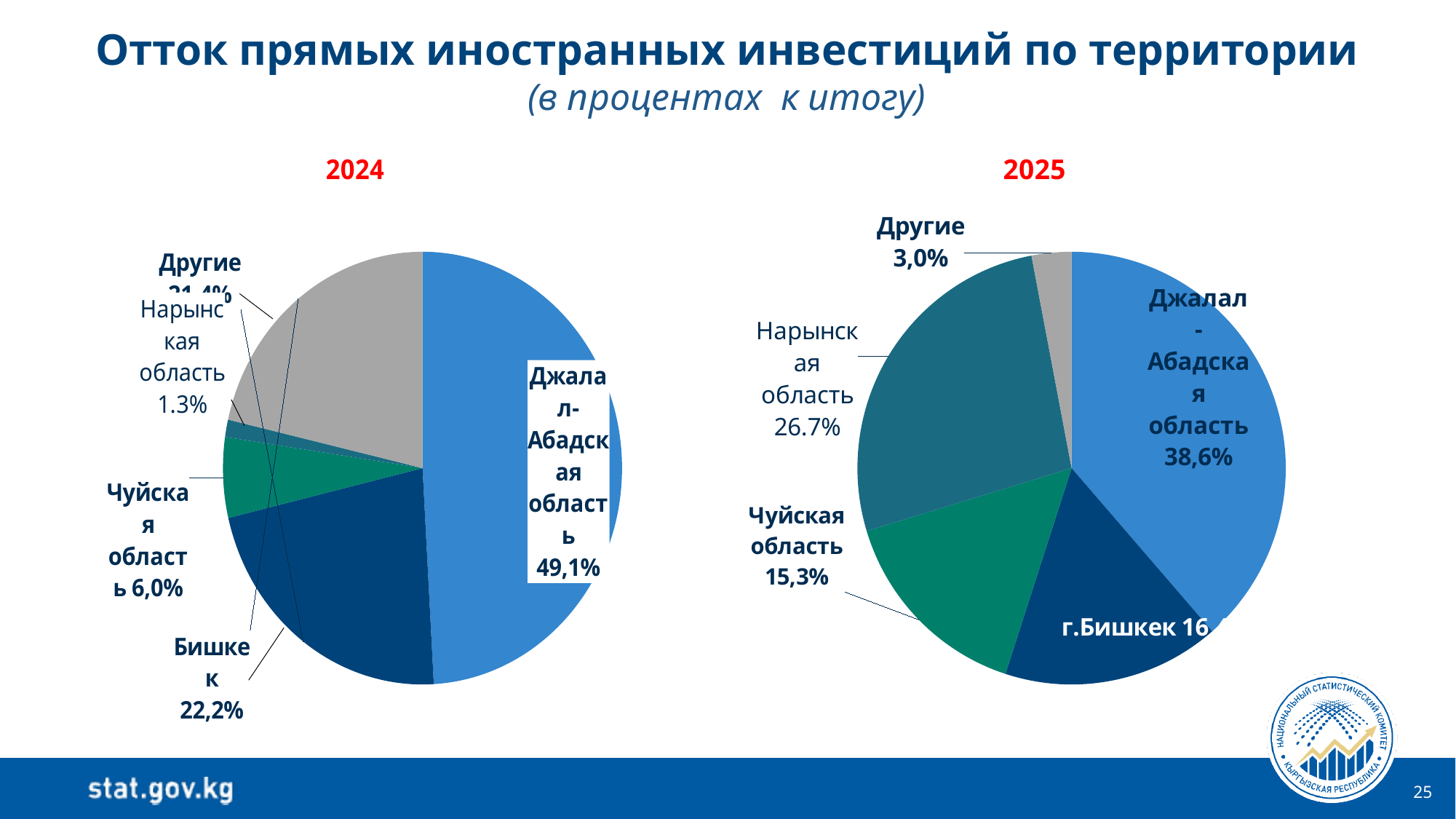
In the 2024 pie chart, what share does Нарынская область have? 1.3% In the 2025 pie chart, which category has the largest share? Джалал-Абадская область In the 2024 pie chart, which category has the smallest share? Нарынская область What type of chart is used on this slide? Pie chart In the 2024 pie chart, what share does Чуйская область have? 6,0% In the 2025 pie chart, what share does Чуйская область have? 15,3% In the 2025 pie chart, what share does Нарынская область have? 26.7% In the 2024 pie chart, what share does Бишкек have? 22,2% In the 2024 pie chart, how many percentage points larger is the share of Джалал-Абадская область than that of Бишкек? 26,9 In the 2024 pie chart, what share does Джалал-Абадская область have? 49,1% In the 2025 pie chart, what share does Джалал-Абадская область have? 38,6% In the 2025 pie chart, what share does Другие have? 3,0%